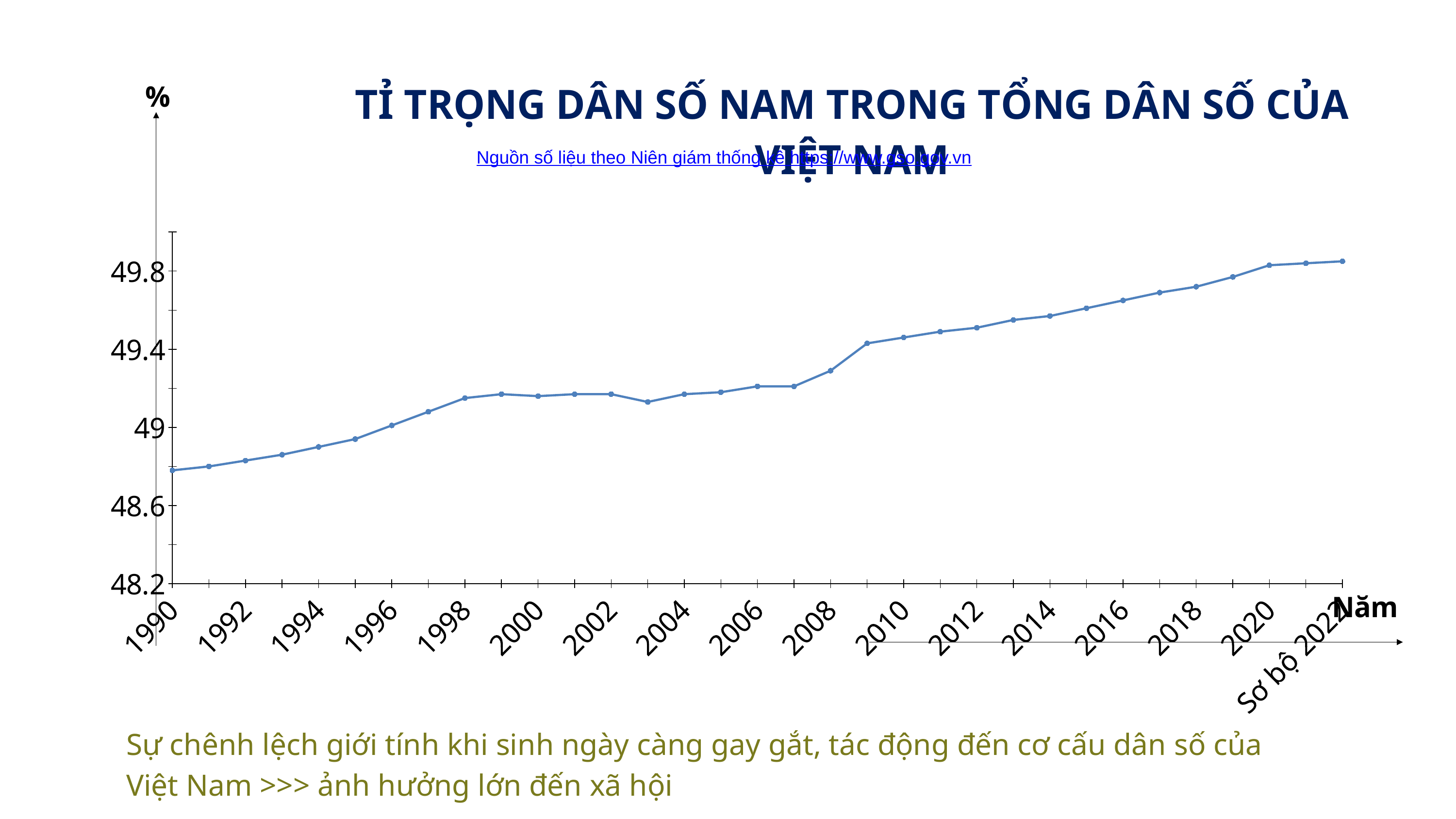
How many data points are plotted on the line? 33 Do the values generally rise or fall from 1990 to 2022? rise Is the value for 2010 greater or less than 49.4? greater What label is shown on the horizontal axis of the chart? Năm Which year has the lowest value on the chart? 1990 What kind of chart is shown on the slide? line chart What is the title of the chart? TỈ TRỌNG DÂN SỐ NAM TRONG TỔNG DÂN SỐ CỦA VIỆT NAM Is the value for 1990 greater or less than 49? less Is the value for 2016 greater or less than 49.8? less Which year has the highest value on the chart? Sơ bộ 2022 Which year has the larger value, 2000 or 2010? 2010